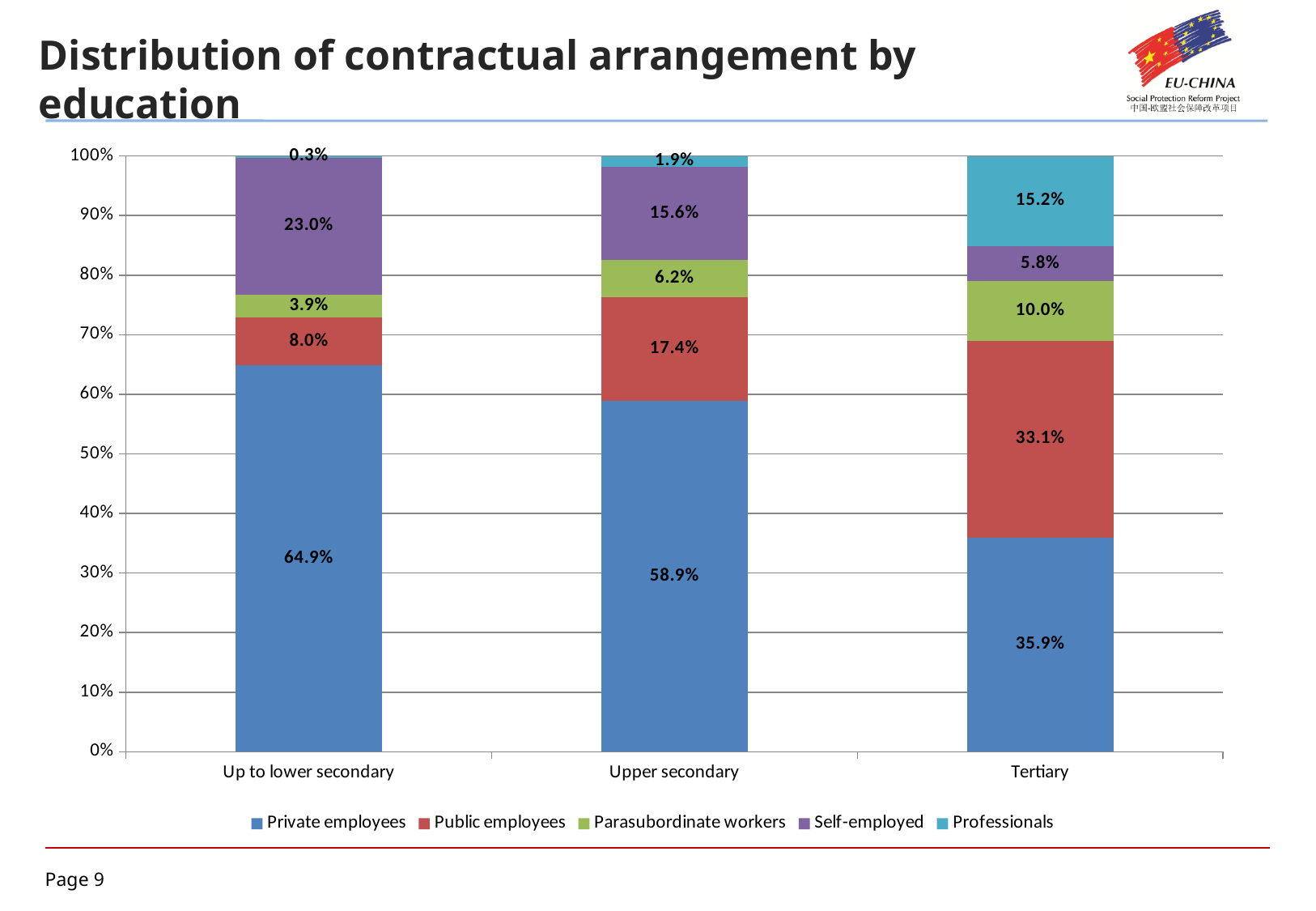
What is the share of Self-employed for Up to lower secondary education? 23.0% How many education categories are shown on the x axis? 3 Which education level has the lowest share of Professionals? Up to lower secondary What is the share of Public employees for Upper secondary education? 17.4% Does the share of Private employees rise or fall from Up to lower secondary to Tertiary? Fall What is the share of Professionals for Tertiary education? 15.2% Which education level has the highest share of Private employees? Up to lower secondary Is the share of Parasubordinate workers larger for Tertiary or for Upper secondary? Tertiary How many series does the legend list? 5 What is the difference between the Public employees share for Tertiary and for Up to lower secondary? 25.1% What kind of chart is shown on the slide? Stacked bar chart What is the share of Private employees for Tertiary education? 35.9%